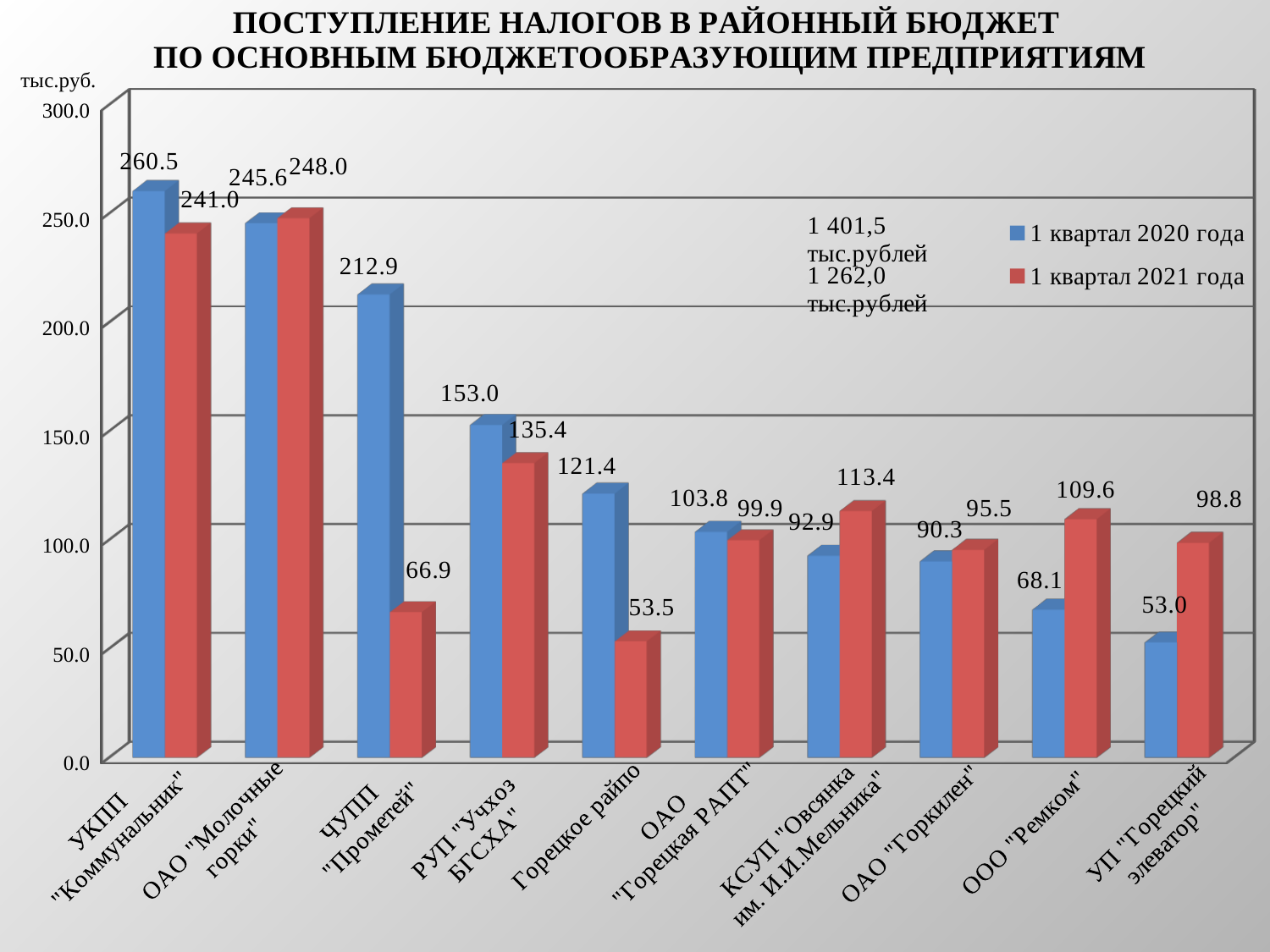
Is the value for РУП "Учхоз БГСХА" in 1 квартал 2020 года greater or less than 150.0? greater For КСУП "Овсянка им. И.И.Мельника", which is larger: the 1 квартал 2020 года value or the 1 квартал 2021 года value? 1 квартал 2021 года How many series does the legend list? 2 What is the value for ООО "Ремком" in 1 квартал 2020 года? 68.1 How many enterprises (categories) are shown on the x axis? 10 Which enterprise has the lowest value for 1 квартал 2021 года? Горецкое райпо What is the difference between the 2020 and 2021 values for Горецкое райпо? 67.9 What is the value for ЧУПП "Прометей" in 1 квартал 2021 года? 66.9 What type of chart is shown on the slide? Bar chart Which enterprise has the highest value for 1 квартал 2020 года? УКПП "Коммунальник" What unit of measurement is indicated on the y axis? тыс.руб. Which colour represents 1 квартал 2021 года in the legend? Red